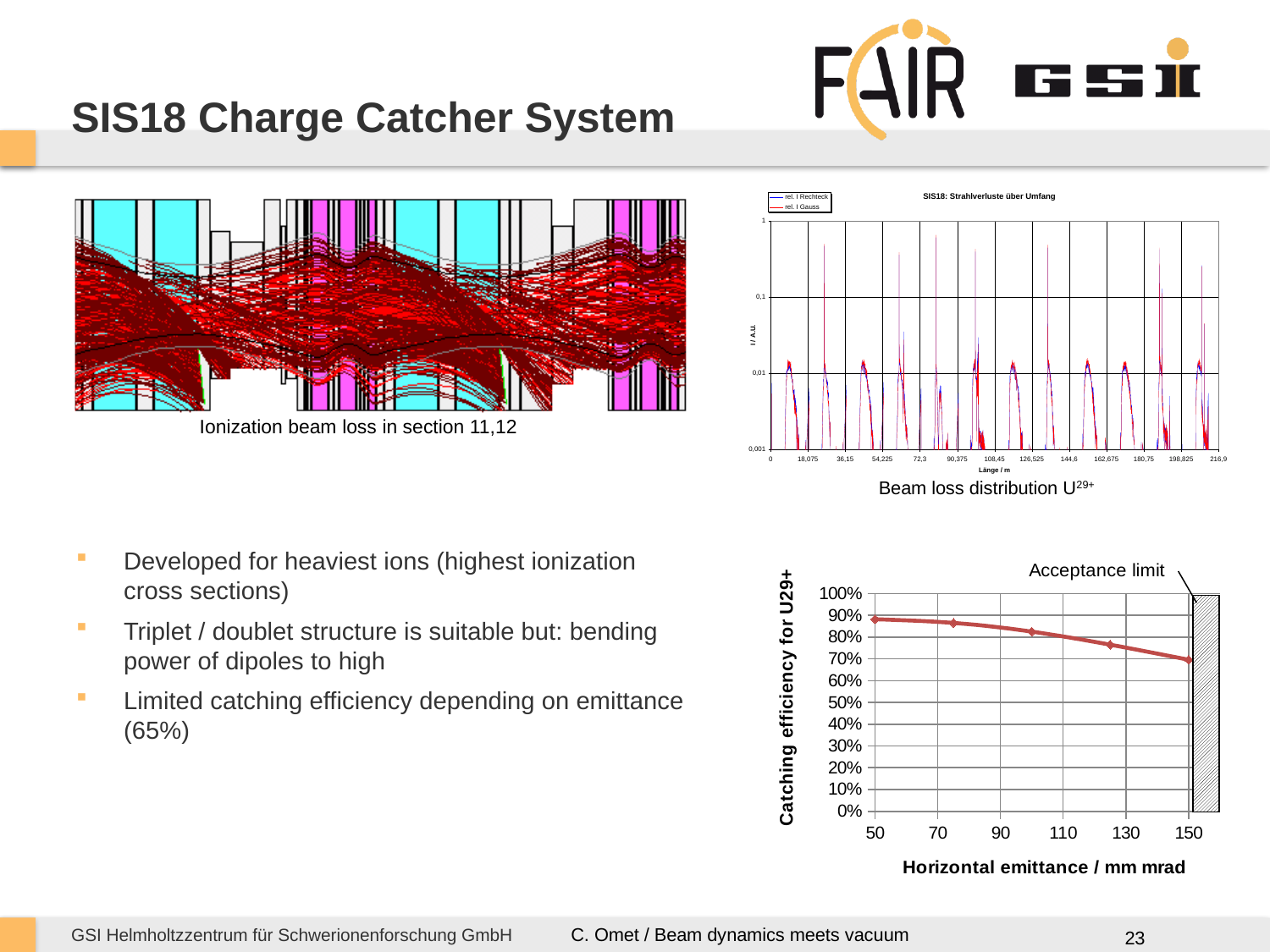
What is the title of the top-right beam loss chart? SIS18: Strahlverluste über Umfang In the bottom-right catching efficiency chart, is the catching efficiency at a horizontal emittance of 125 mm mrad greater or less than 70%? greater What kind of chart is the top-right beam loss distribution chart? line chart In the bottom-right catching efficiency chart, which has the higher catching efficiency: a horizontal emittance of 50 mm mrad or 150 mm mrad? 50 mm mrad In the bottom-right catching efficiency chart, is the catching efficiency at a horizontal emittance of 50 mm mrad greater or less than 80%? greater What kind of chart is the bottom-right chart of catching efficiency versus horizontal emittance? line chart In the bottom-right catching efficiency chart, is the catching efficiency at a horizontal emittance of 150 mm mrad greater or less than 80%? less How many series does the legend of the top-right beam loss chart list? 2 In the bottom-right catching efficiency chart, do the values rise or fall as horizontal emittance increases? fall In the bottom-right catching efficiency chart, at which horizontal emittance is the catching efficiency lowest? 150 How many data points are plotted in the bottom-right catching efficiency chart? 5 What is the x-axis label of the bottom-right catching efficiency chart? Horizontal emittance / mm mrad